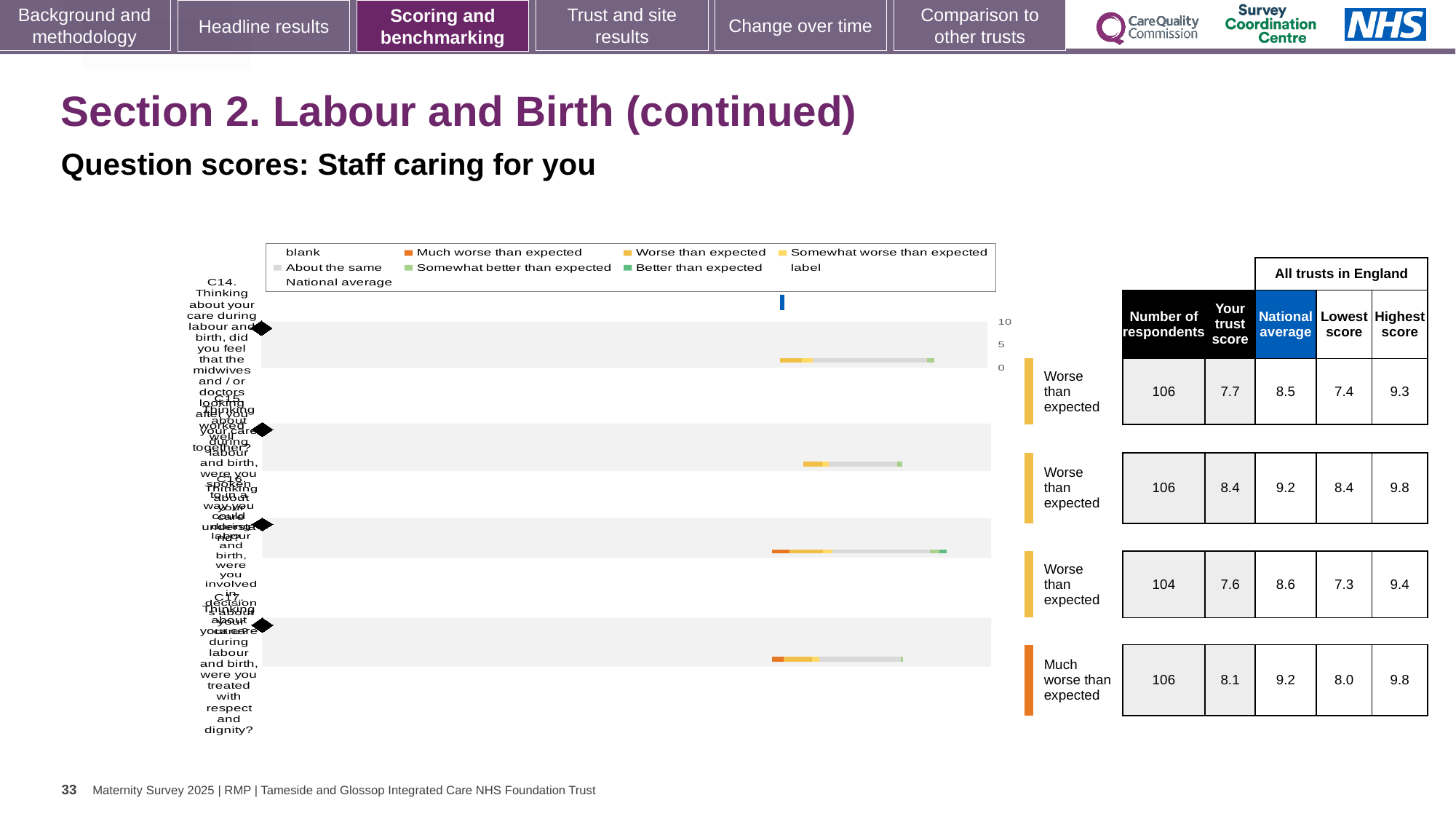
In the table beside the chart, what is the number of respondents for the third row? 104 How many of the four rows are rated 'Worse than expected' (as opposed to 'Much worse than expected')? 3 In the table beside the chart, which row has the highest 'Your trust score'? the second row (8.4) How many question rows (bars) does the chart show? 4 In the table beside the chart, what is the number of respondents for the first row? 106 In the table beside the chart, which row has the lowest 'Your trust score'? the third row (7.6) In the chart legend, what colour represents 'Much worse than expected'? orange For the second row of the table, which is larger: the trust score or the national average? the national average (9.2) For the first row of the table, what is the difference between the national average and the trust score? 0.8 In the table beside the chart, what is the 'Your trust score' for the second row? 8.4 What kind of chart is shown on the slide? bar chart What is the highest tick value shown on the chart's score axis? 10